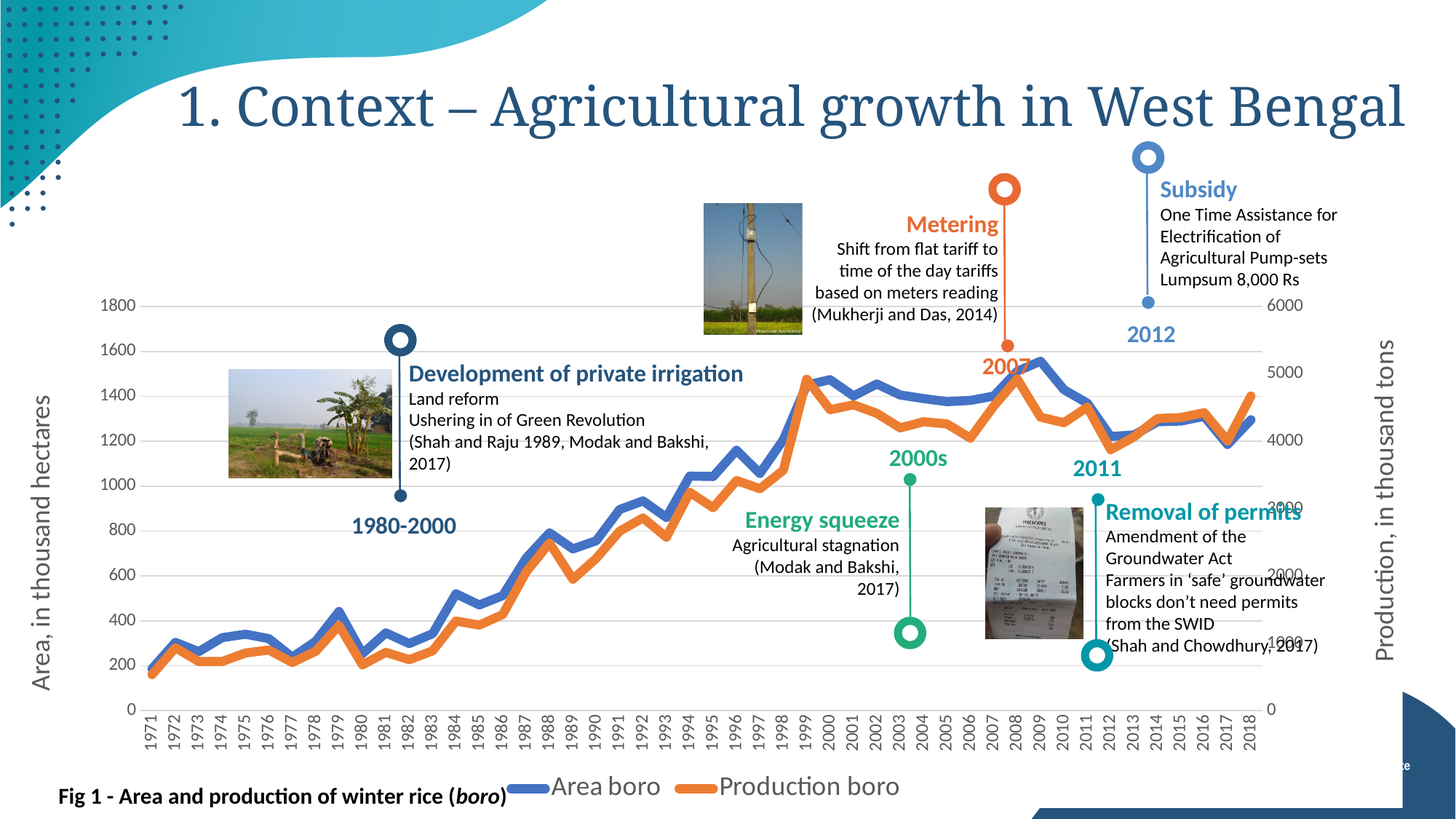
How many series does the chart legend list? 2 Is the Area boro value for 1971 greater or less than 400? less What is the title of the left vertical axis of the chart? Area, in thousand hectares How many years are plotted along the x axis of the chart? 48 What are the two series named in the chart legend? Area boro and Production boro Is the Production boro value for 2008 greater or less than 4000? greater Does the Area boro series generally rise or fall between 1971 and 2009? Rise Is the Area boro value for 2009 greater or less than 1400? greater What kind of chart is shown on the slide? Line chart In which year is the Area boro series at its lowest value? 1971 In which year does the Area boro series reach its highest value? 2009